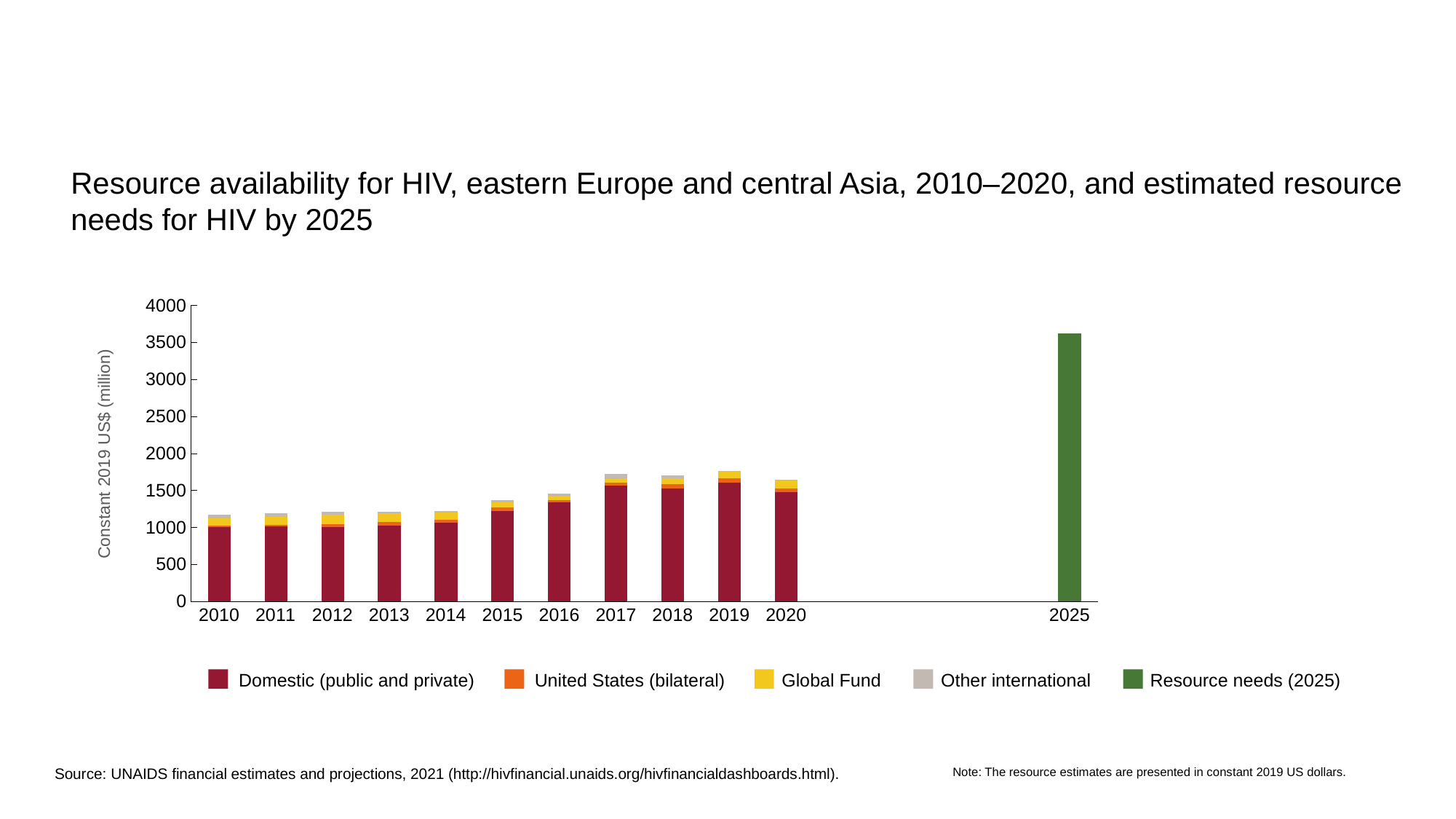
Is the total resource availability for 2019 greater or less than 2000? less Which year has the tallest bar on the chart? 2025 Do total resource availability values generally rise or fall from 2010 to 2017? rise What kind of chart is shown on the slide? Stacked bar chart Is the total resource availability for 2014 greater or less than 1500? less Is the total resource availability for 2017 greater or less than 1500? greater How many series does the legend list? 5 Which bar is taller, 2010 or 2017? 2017 What is the label on the vertical axis? Constant 2019 US$ (million) How many bars are plotted on the chart? 12